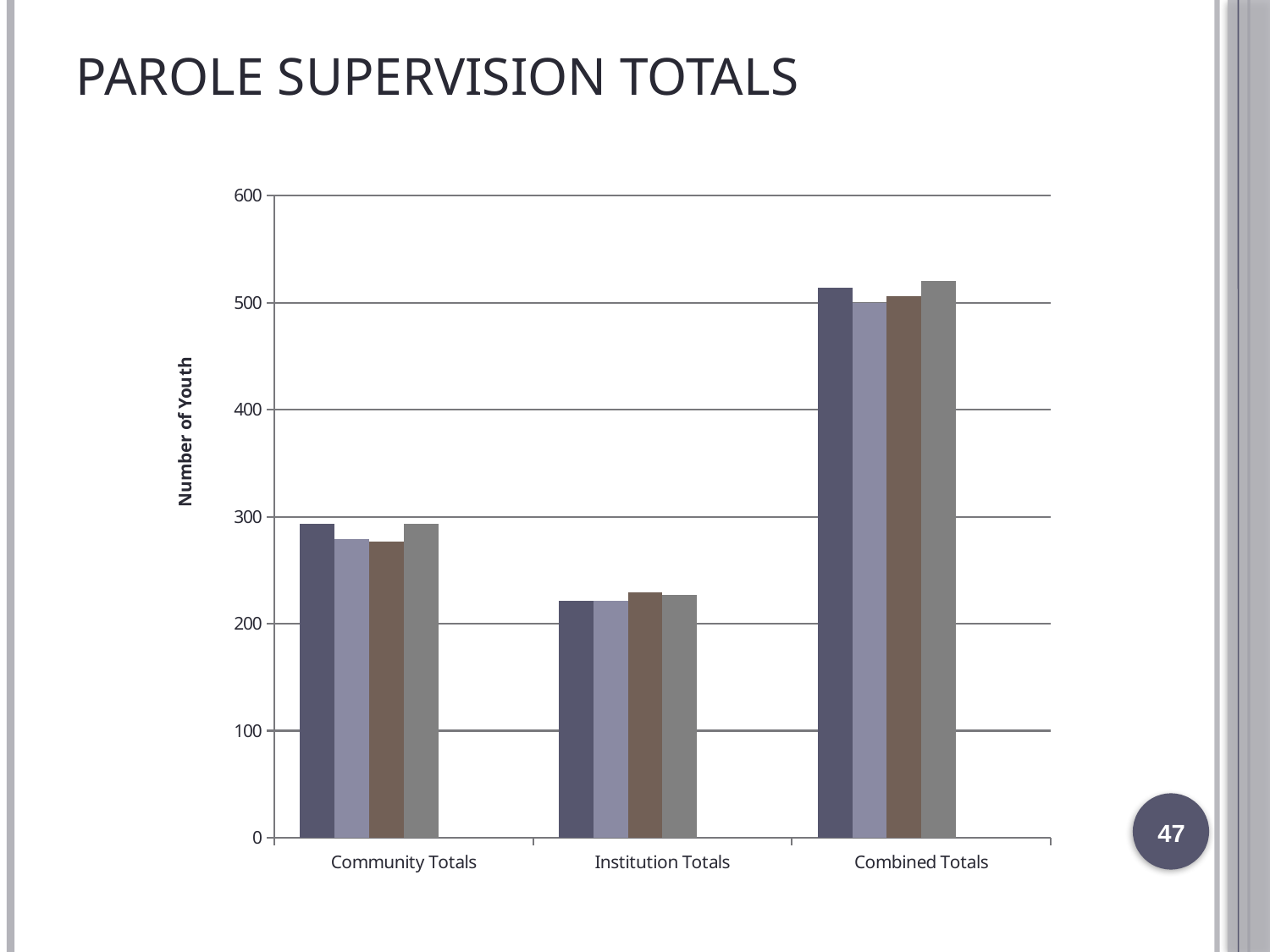
Which category has the lowest values in the chart? Institution Totals How many categories are shown on the x axis of the chart? 3 Which is larger, the dark blue bar for Community Totals or the dark blue bar for Institution Totals? Community Totals What type of chart is shown on the slide? bar chart Are the values for Community Totals greater or less than 250? greater Are the values for Institution Totals greater or less than 300? less Are the values for Combined Totals greater or less than 400? greater What is the title of the chart on the slide? Parole Supervision Totals What is the label on the vertical axis of the chart? Number of Youth How many bars are plotted for each category in the chart? 4 Which category has the highest values in the chart? Combined Totals